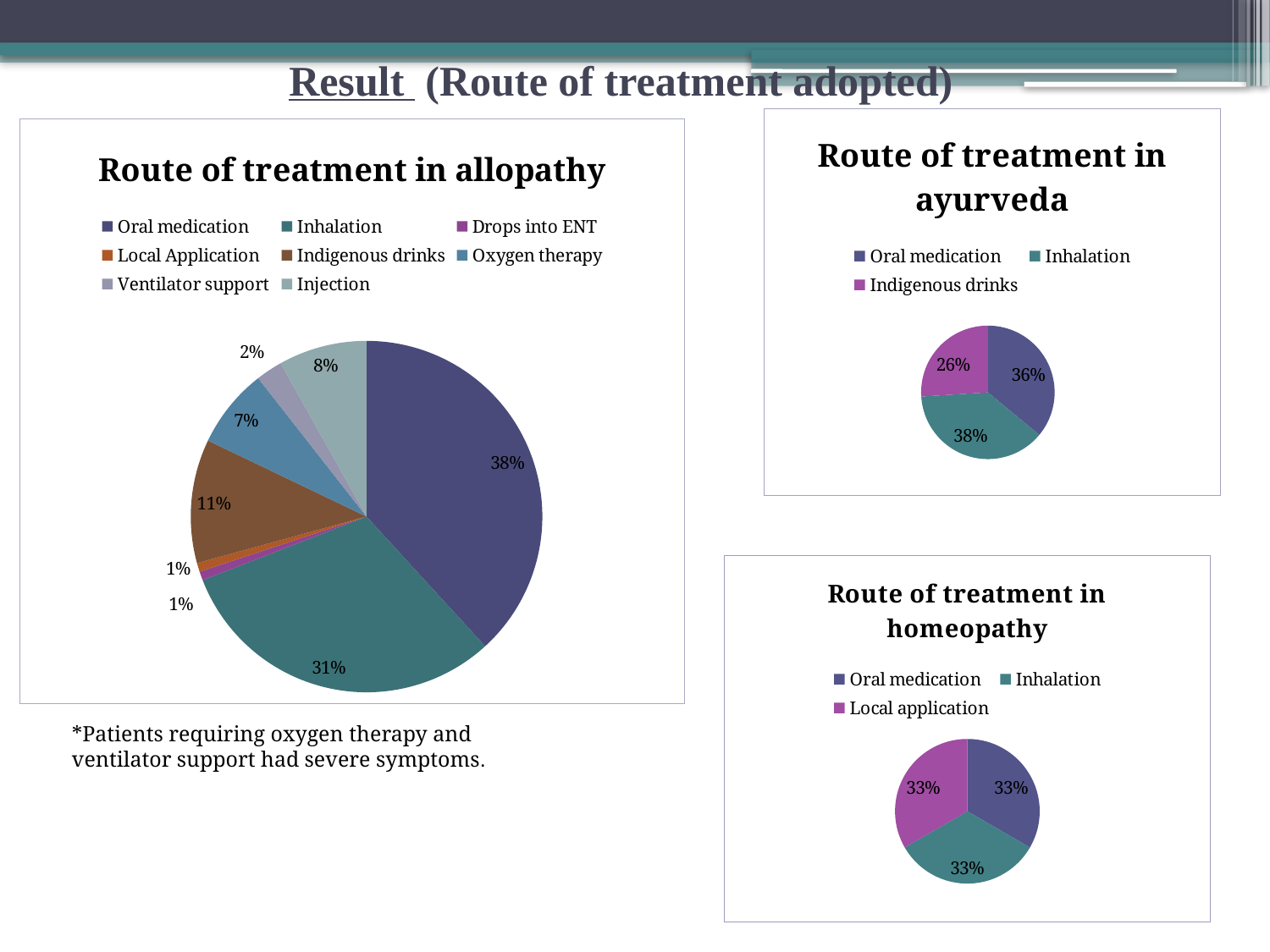
In the 'Route of treatment in allopathy' chart, what share is Inhalation? 31% In the 'Route of treatment in allopathy' chart, what share is Oral medication? 38% In the 'Route of treatment in ayurveda' chart, what share is Inhalation? 38% In the 'Route of treatment in allopathy' chart, what is the difference between the Oral medication and Inhalation shares? 7% In the 'Route of treatment in ayurveda' chart, is the share for Oral medication larger or smaller than the share for Inhalation? smaller In the 'Route of treatment in allopathy' chart, what share is Injection? 8% In the 'Route of treatment in homeopathy' chart, what share is Local application? 33% What kind of chart is the 'Route of treatment in homeopathy' chart? Pie chart How many categories does the legend of the 'Route of treatment in allopathy' chart list? 8 In the 'Route of treatment in ayurveda' chart, which route has the smallest share? Indigenous drinks In the 'Route of treatment in allopathy' chart, which route has the largest share? Oral medication In the 'Route of treatment in allopathy' chart, what share is Indigenous drinks? 11%